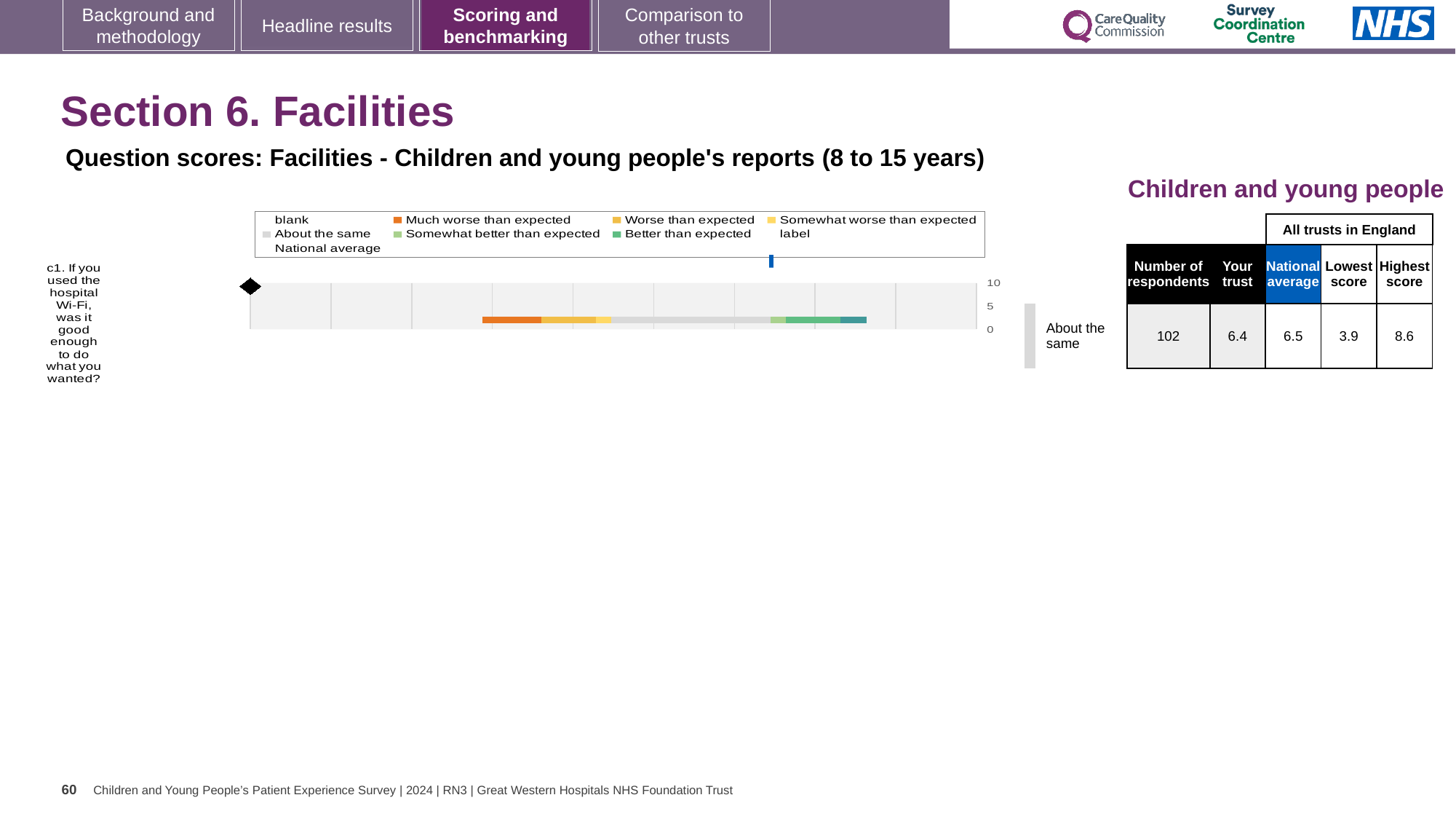
What is the 'Your trust' score for question c1? 6.4 What benchmark category is the trust's score for question c1 assigned to? About the same What is the difference between the highest score and the lowest score for question c1? 4.7 What is the national average score for question c1? 6.5 What is the lowest score among all trusts in England for question c1? 3.9 How many survey questions are plotted in the chart? 1 What is the highest score among all trusts in England for question c1? 8.6 Which is larger for question c1, the trust's score or the national average? national average What is the question label shown on the chart's category axis? c1. If you used the hospital Wi-Fi, was it good enough to do what you wanted? What kind of chart is shown on the slide? bar chart What is the highest value shown on the chart's score axis? 10 How many respondents answered question c1? 102